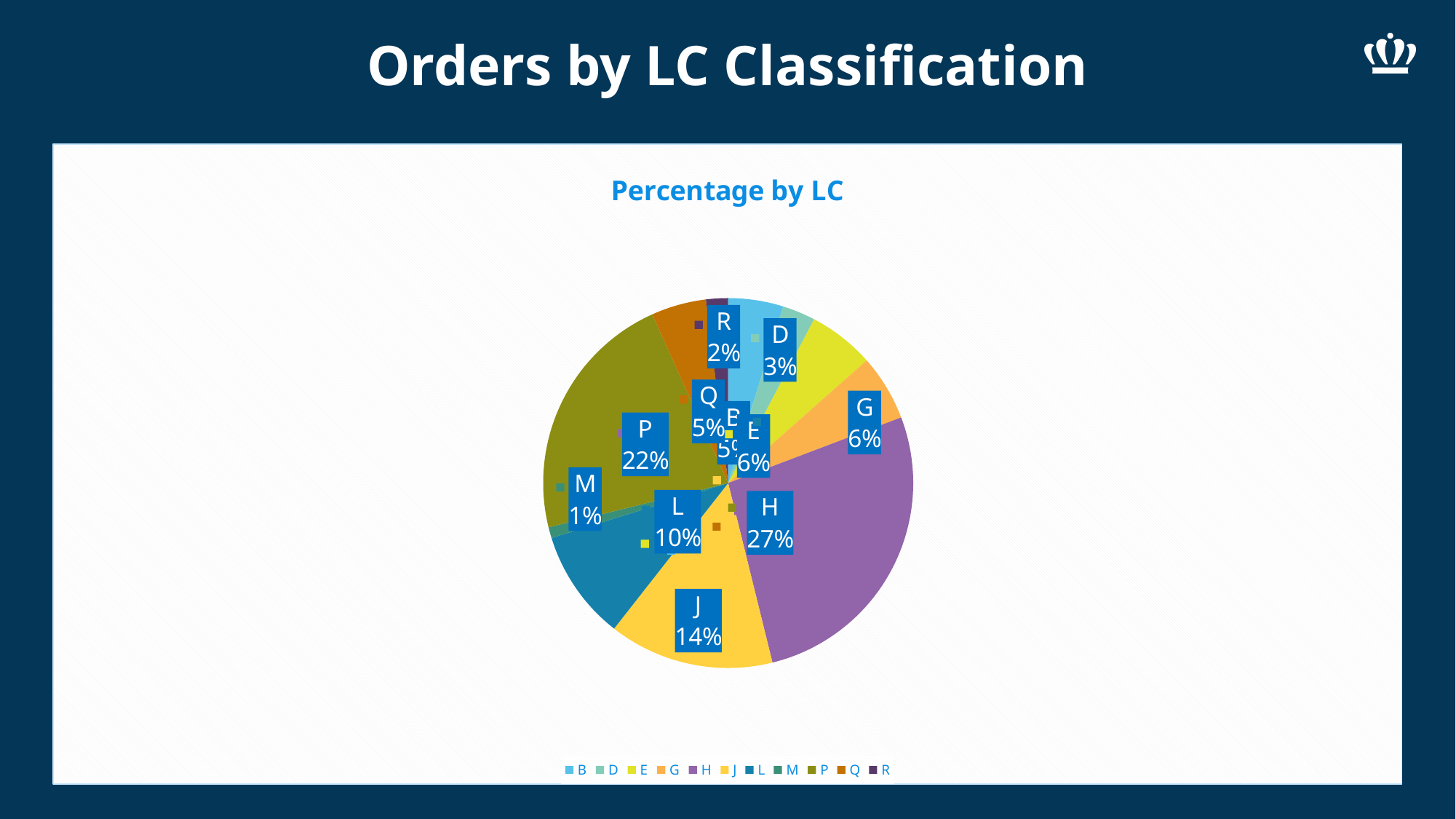
How many categories does the legend list? 11 How many percentage points larger is the share for H than the share for P? 5 What is the title of the chart? Percentage by LC What percentage of orders is classification H? 27% What kind of chart is shown on the slide? pie chart Which LC classification has the smallest share of orders? M What percentage of orders is classification L? 10% What percentage of orders is classification D? 3% What percentage of orders is classification P? 22% Which has a larger share of orders, J or L? J Which LC classification has the largest share of orders? H What percentage of orders is classification J? 14%